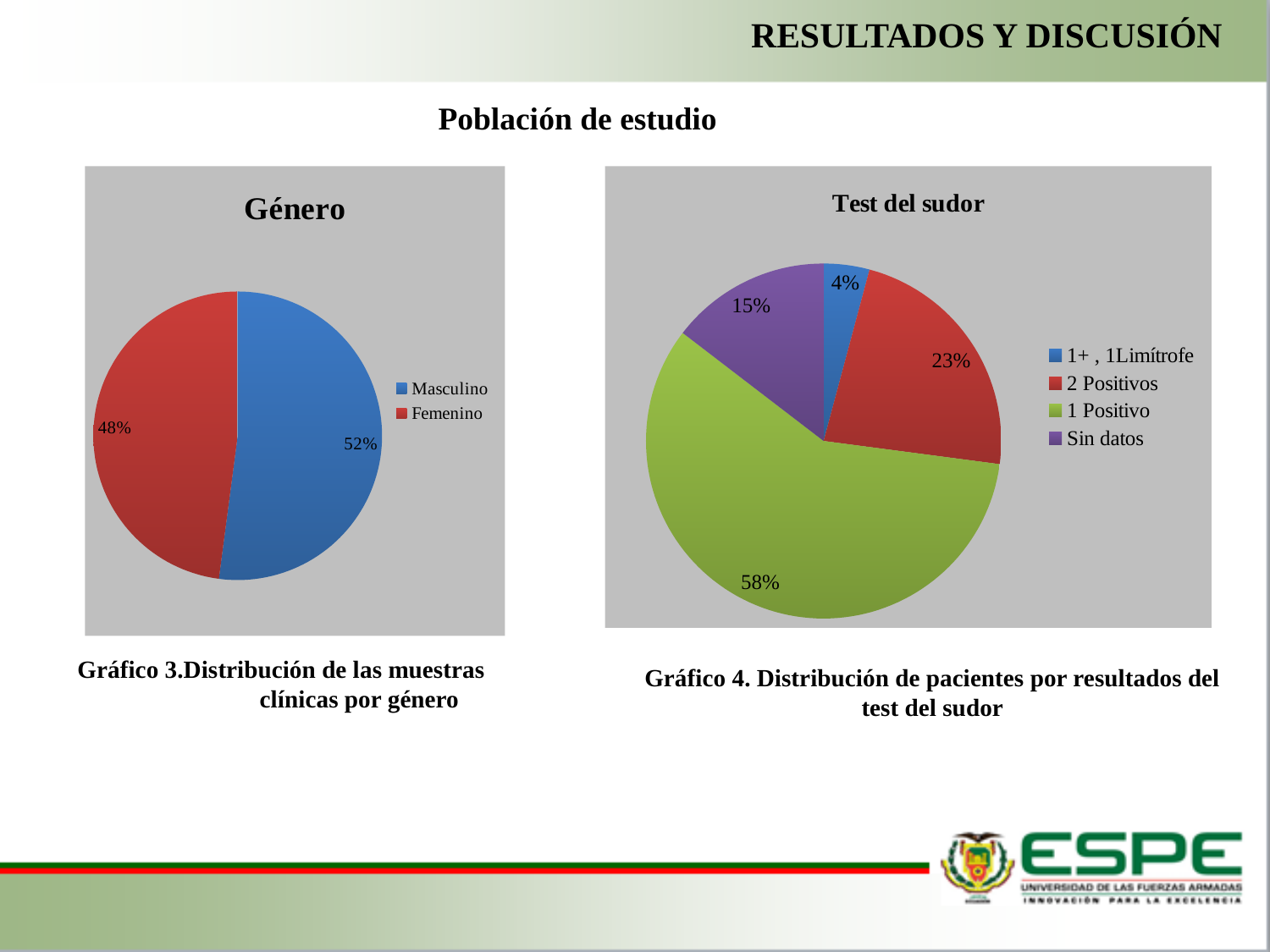
In the 'Test del sudor' chart, which category has the smallest share? 1+ , 1Limítrofe In the 'Test del sudor' chart, what share of the pie is Sin datos? 15% In the 'Test del sudor' chart, what share of the pie is 2 Positivos? 23% In the 'Género' chart, which category has the larger share, Masculino or Femenino? Masculino In the 'Género' chart, what is the difference in percentage points between Masculino and Femenino? 4 In the 'Test del sudor' chart, what is the difference in percentage points between 1 Positivo and 2 Positivos? 35 In the 'Test del sudor' chart, which category has the largest share? 1 Positivo In the 'Género' chart, what share of the pie is Femenino? 48% How many categories does the legend of the 'Test del sudor' chart list? 4 What kind of chart is the 'Género' chart? Pie chart